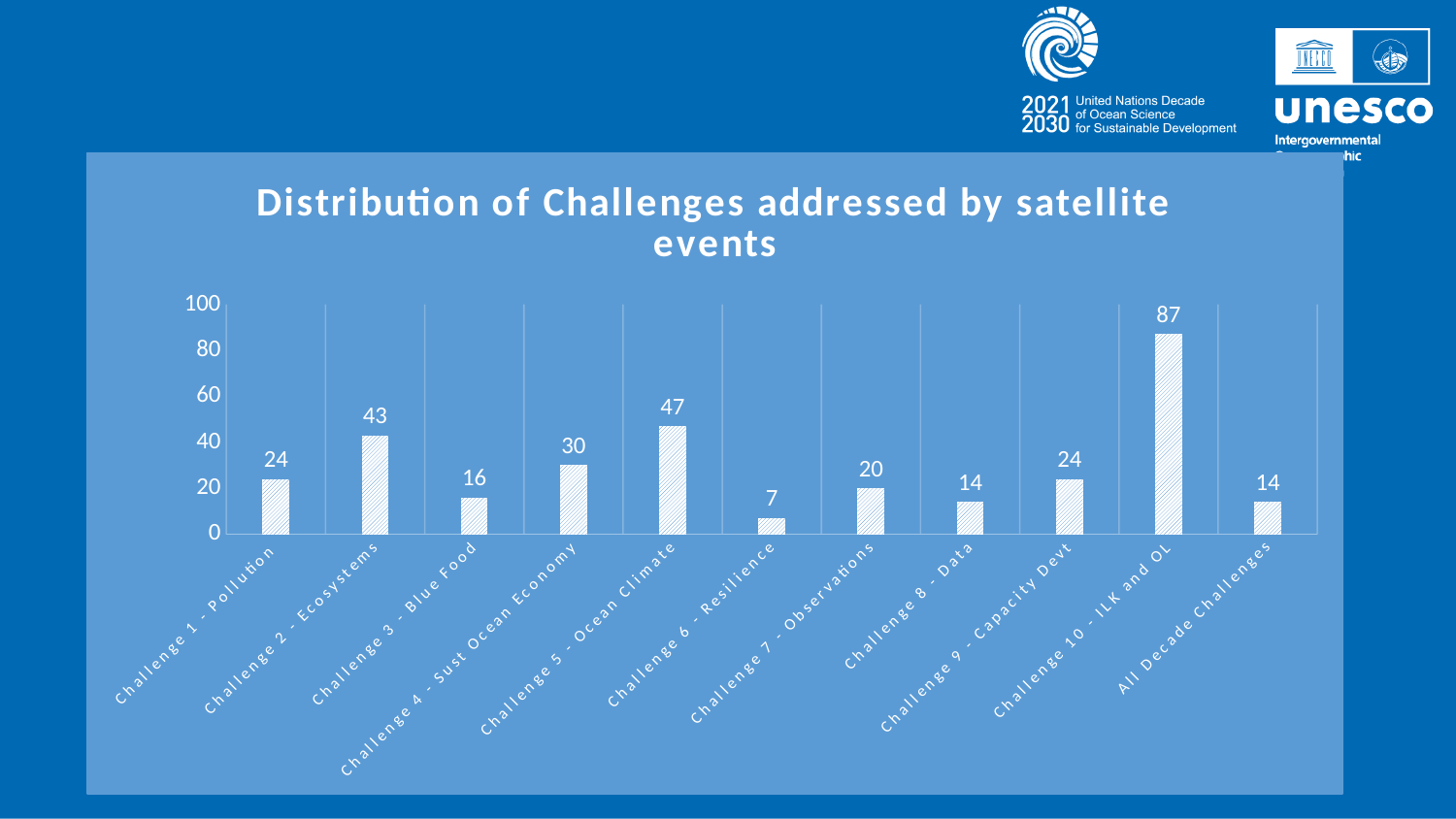
What is the value for Challenge 2 - Ecosystems? 43 Which category has the lowest value? Challenge 6 - Resilience Is the value for Challenge 10 - ILK and OL greater or less than 80? greater What is the value for All Decade Challenges? 14 Which category has the highest value? Challenge 10 - ILK and OL How many categories are shown on the x axis? 11 What kind of chart is shown on the slide? Bar chart What is the difference between the values for Challenge 5 - Ocean Climate and Challenge 4 - Sust Ocean Economy? 17 What is the value for Challenge 10 - ILK and OL? 87 What is the title of the chart? Distribution of Challenges addressed by satellite events Which is larger, the value for Challenge 1 - Pollution or the value for Challenge 3 - Blue Food? Challenge 1 - Pollution What is the value for Challenge 6 - Resilience? 7